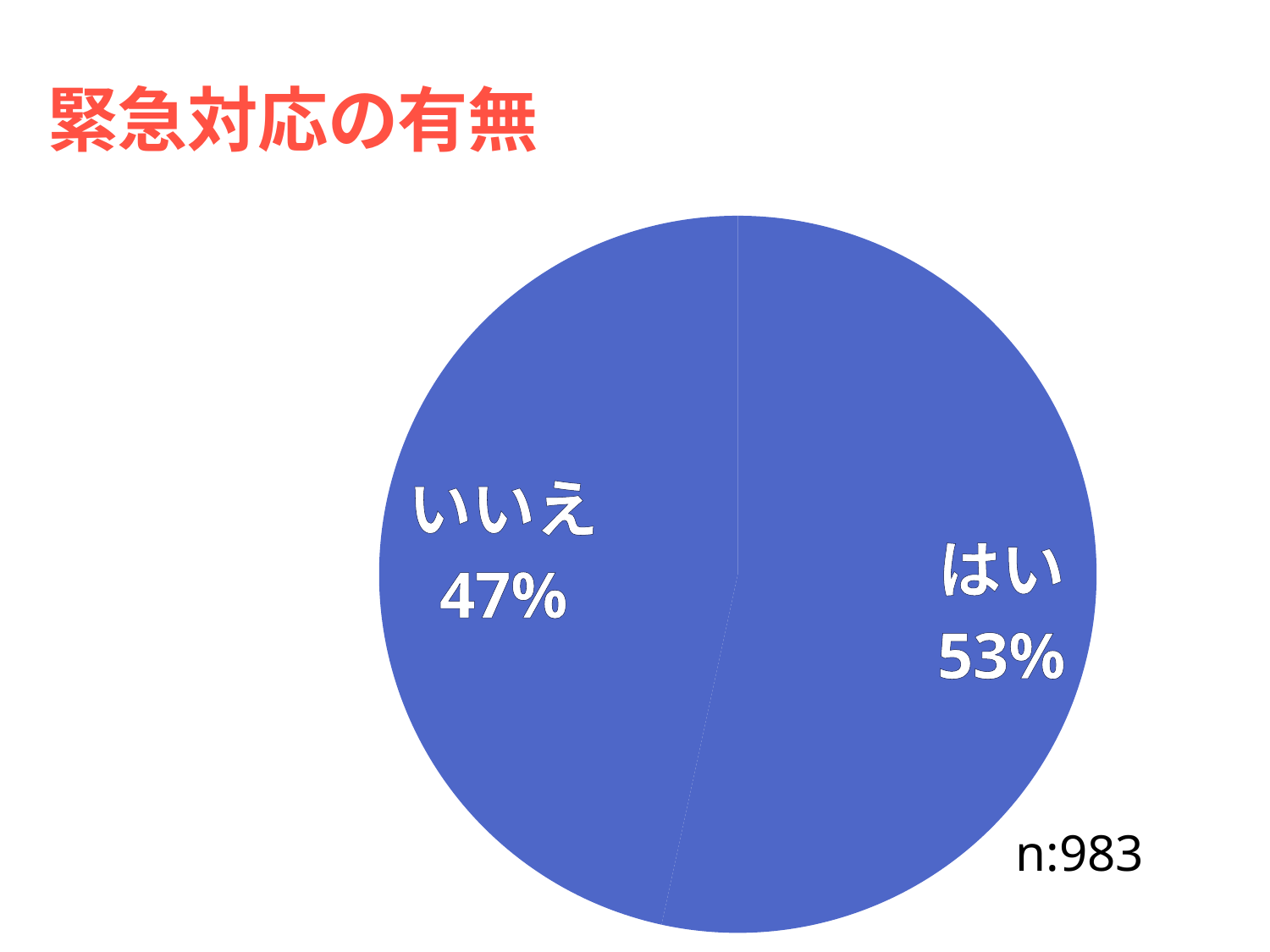
How many slices does the pie chart have? 2 Which slice is the largest? はい What kind of chart is shown on the slide? pie chart Which is larger, はい or いいえ? はい What is the difference in percentage points between はい and いいえ? 6 What share of the pie does はい represent? 53% Which slice is the smallest? いいえ What share of the pie does いいえ represent? 47% What is the title of the chart? 緊急対応の有無 What is the sample size (n) shown on the slide? 983